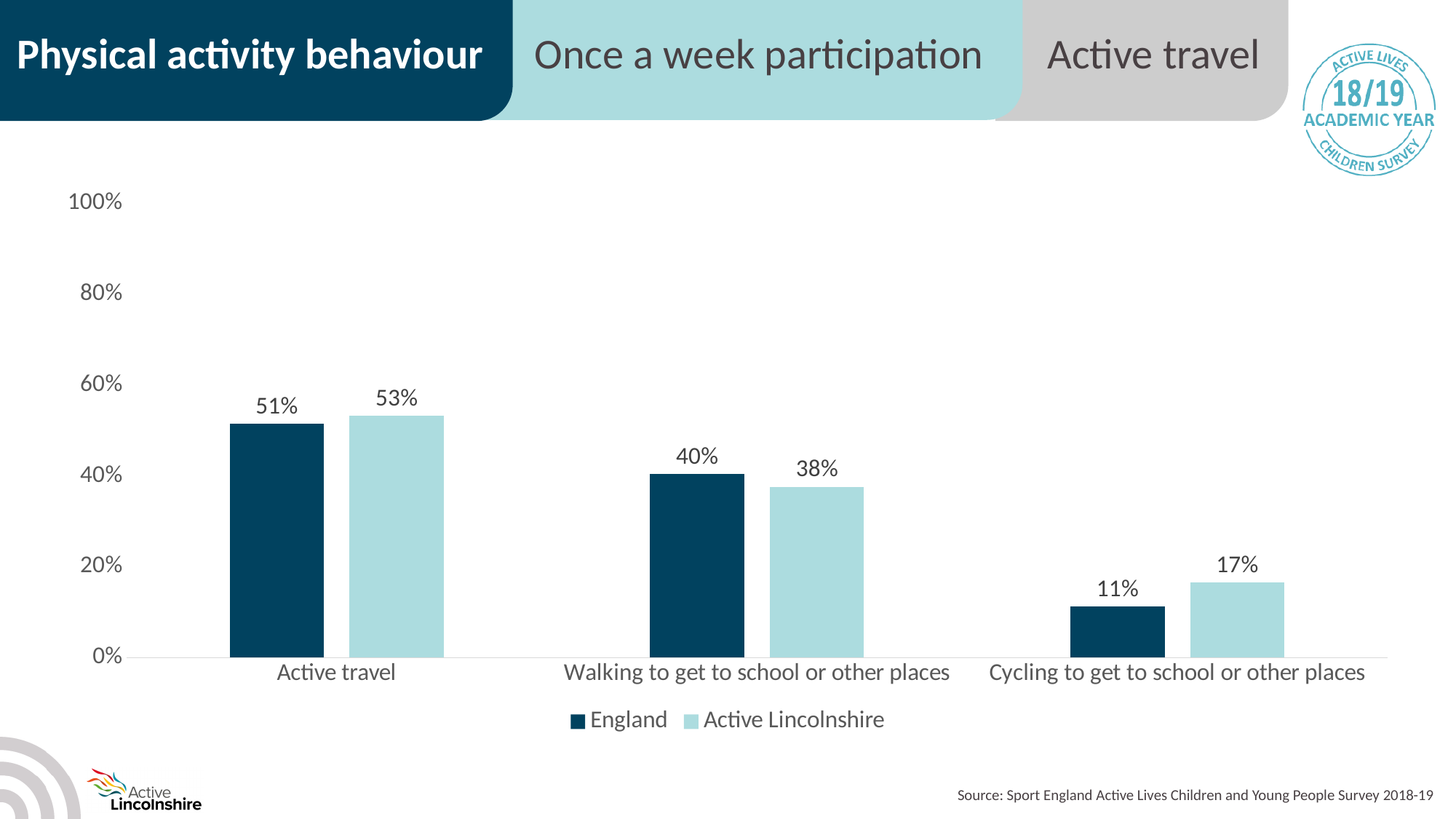
Which category has the lowest value for England? Cycling to get to school or other places What are the two series named in the legend? England and Active Lincolnshire For Walking to get to school or other places, which is larger: England or Active Lincolnshire? England How many categories are shown on the x axis? 3 What is the value for Active Lincolnshire for Walking to get to school or other places? 38% Which category has the highest value for Active Lincolnshire? Active travel Is the value for England for Active travel greater or less than 40%? greater What is the value for Active Lincolnshire for Cycling to get to school or other places? 17% How many series does the legend list? 2 What kind of chart is shown on the slide? Bar chart What is the difference between Active Lincolnshire and England for Cycling to get to school or other places? 6% What is the value for England for Active travel? 51%